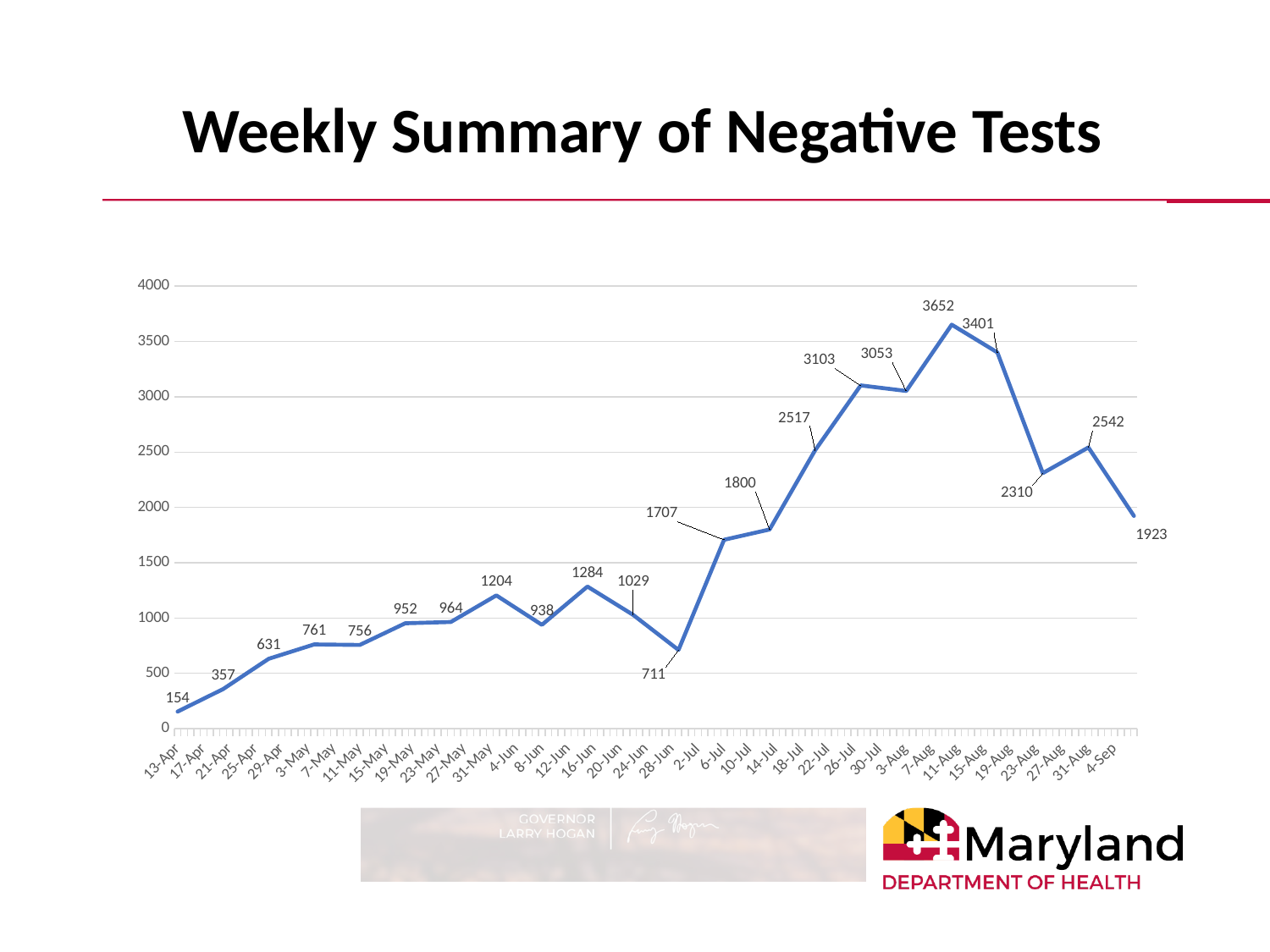
What is the value of the last data point on the line? 1923 What is the title of the chart? Weekly Summary of Negative Tests Which is larger, the point labeled 3103 or the point labeled 3053? 3103 How many data points are labeled on the line? 22 Is the peak value of the line greater or less than 3500? greater Does the line generally rise or fall from 13-Apr to its peak in August? rise What is the difference between the peak value of 3652 and the next point, 3401? 251 What is the lowest value labeled on the line? 154 What kind of chart is shown on the slide? line chart What is the difference between the highest labeled value and the lowest labeled value? 3498 What is the highest value labeled on the line? 3652 What is the value of the first data point, at 13-Apr? 154